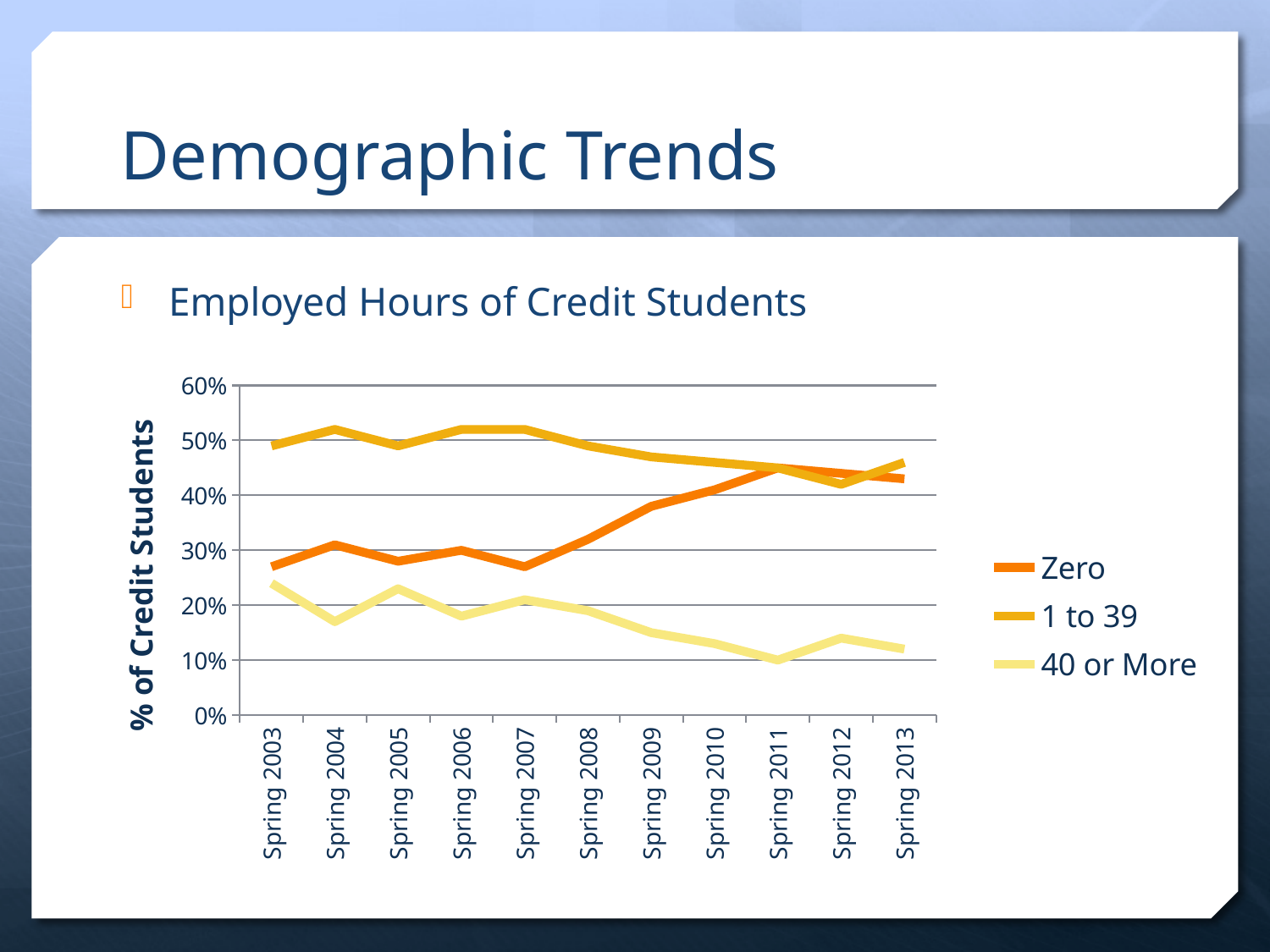
In Spring 2003, which is larger: Zero or 40 or More? Zero Is the value for 1 to 39 in Spring 2006 greater or less than 50%? greater What kind of chart is shown on the slide? line chart Does the 40 or More series rise or fall overall from Spring 2003 to Spring 2013? fall How many time points are plotted along the x axis? 11 Does the Zero series rise or fall overall from Spring 2003 to Spring 2013? rise In Spring 2008, which is larger: Zero or 1 to 39? 1 to 39 How many series does the legend list? 3 Is the value for 40 or More in Spring 2009 greater or less than 20%? less What is the title of the y axis? % of Credit Students Which series has the highest value in Spring 2003? 1 to 39 Is the value for Zero in Spring 2011 greater or less than 40%? greater